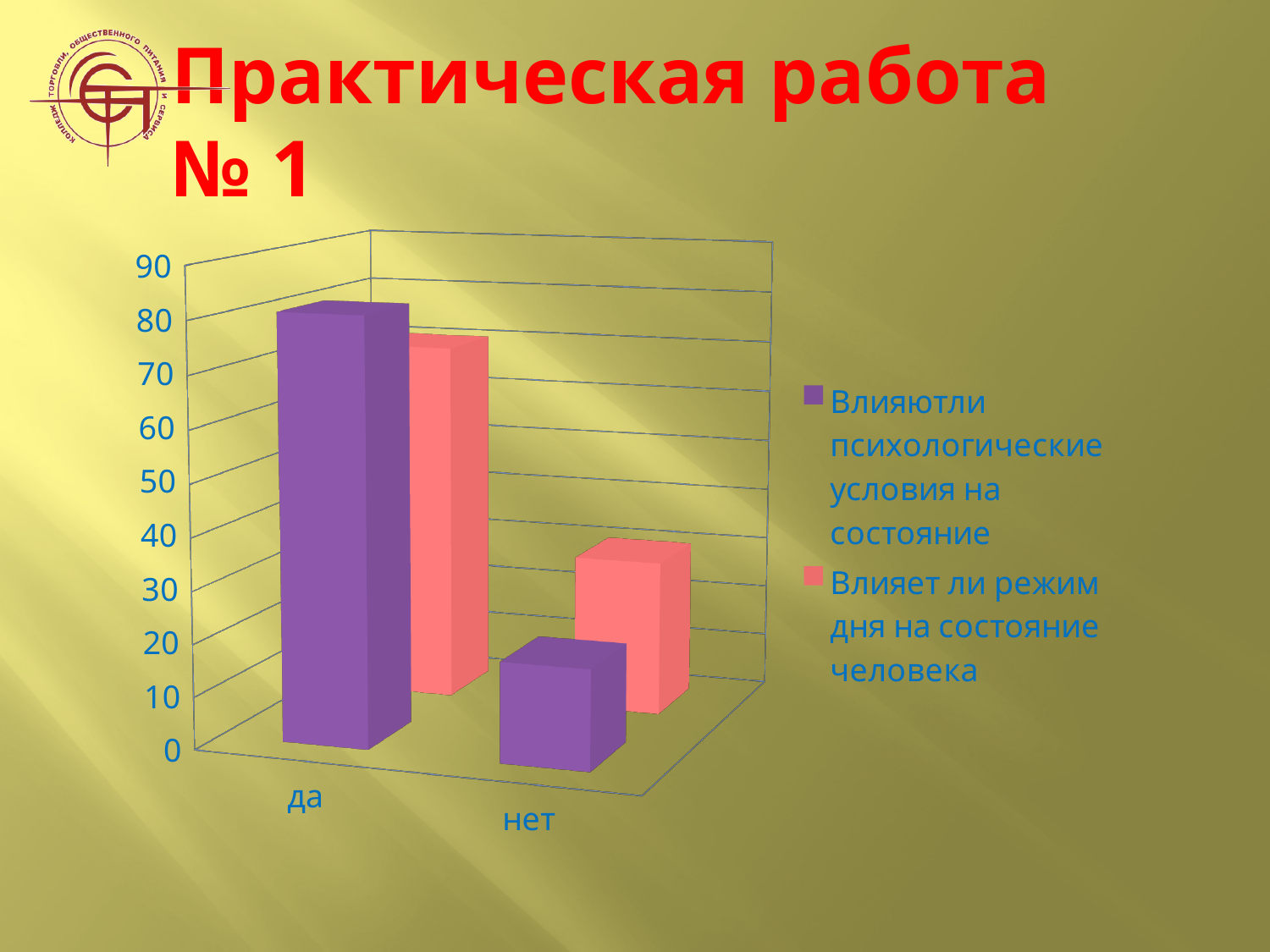
Is the value for 'да' in the series 'Влияютли психологические условия на состояние' greater or less than 50? greater Is the value for 'нет' in the series 'Влияет ли режим дня на состояние человека' greater or less than 50? less How many series does the chart legend list? 2 What kind of chart is shown on the slide? bar chart Which category has the shortest bar for the series 'Влияет ли режим дня на состояние человека'? нет Is the value for 'да' in the series 'Влияет ли режим дня на состояние человека' greater or less than 40? greater What is the highest value shown on the chart's vertical axis? 90 For the category 'нет', which series has the larger value: 'Влияютли психологические условия на состояние' or 'Влияет ли режим дня на состояние человека'? Влияет ли режим дня на состояние человека How many categories are shown on the x axis of the chart? 2 What colour represents the series 'Влияет ли режим дня на состояние человека' in the chart? pink Which category has the tallest bar for the series 'Влияютли психологические условия на состояние'? да